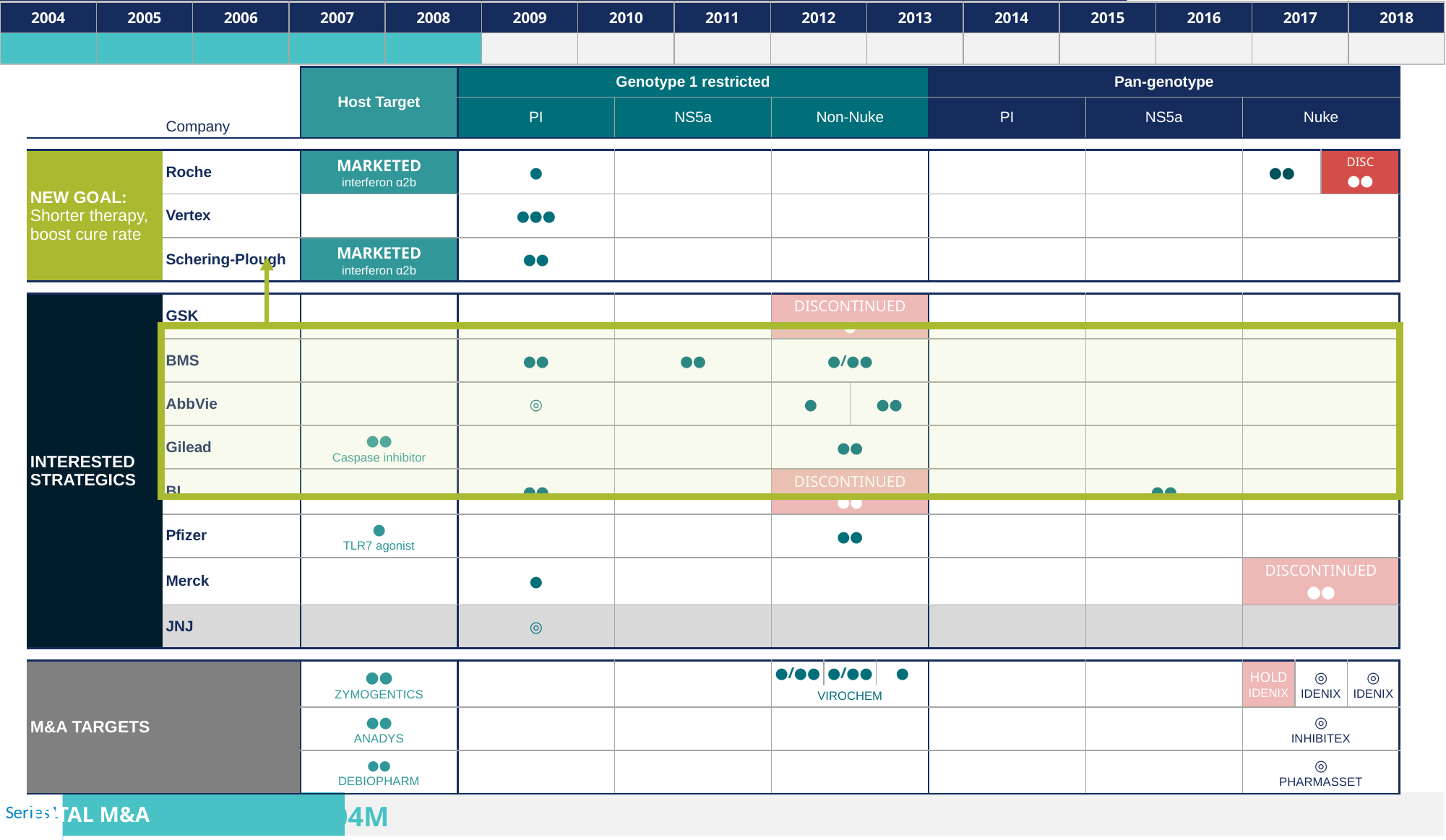
What kind of chart is at the bottom of the slide, next to the 'TOTAL M&A' label? bar chart What is the last year shown on the timeline at the top of the slide? 2018 How many years are shown along the timeline at the top of the slide? 15 What is the name of the series shown in the legend of the bottom chart? Series1 What is the first year shown on the timeline at the top of the slide? 2004 Through which year does the shaded teal bar on the top timeline extend? 2008 What colour is the bar in the bottom chart? teal